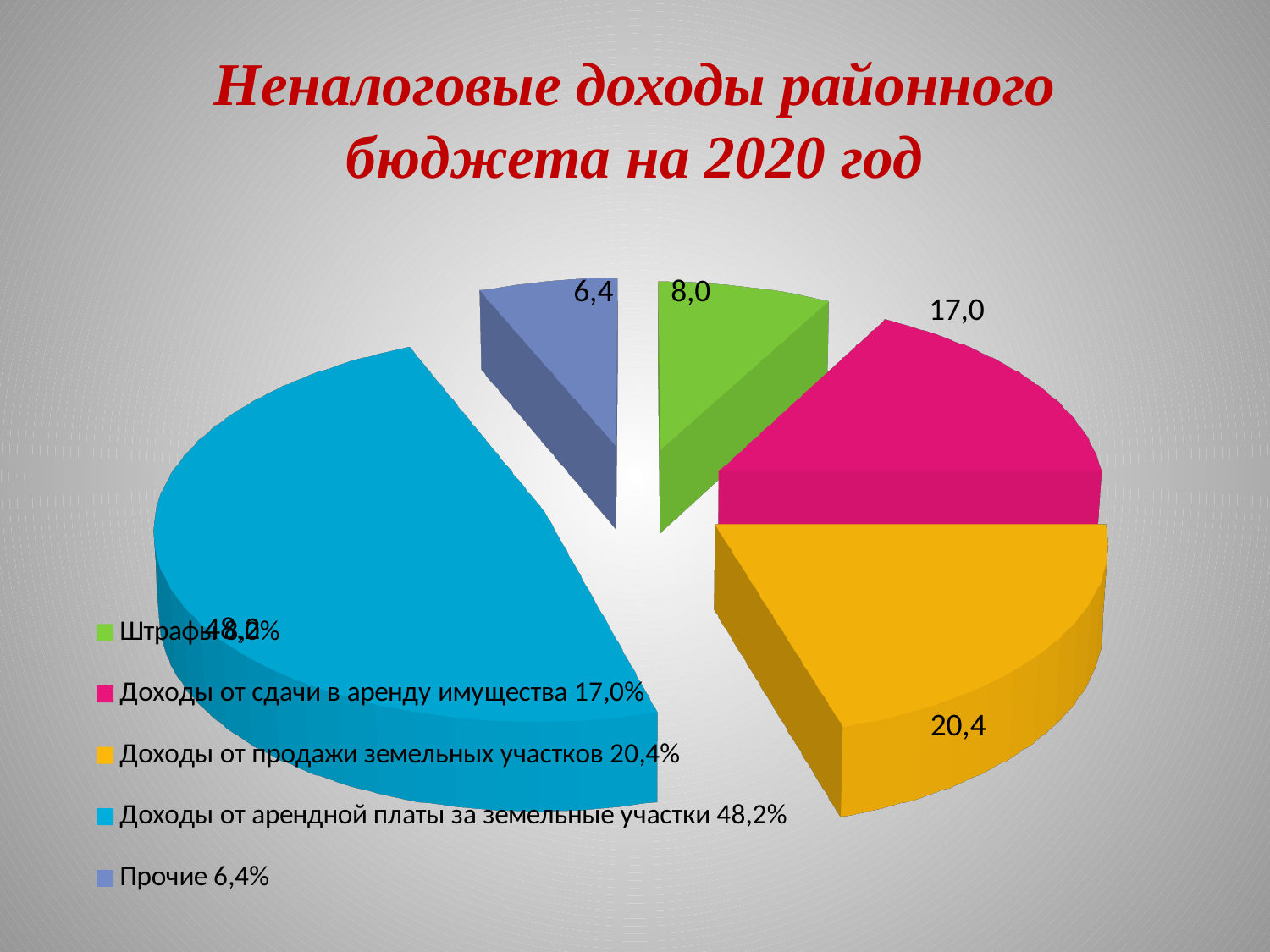
What kind of chart is shown on the slide? pie chart What is the value shown for Прочие? 6,4 What is the title of the chart on the slide? Неналоговые доходы районного бюджета на 2020 год What is the value shown for Штрафы? 8,0 Which category has the largest slice of the pie? Доходы от арендной платы за земельные участки What is the difference between the values for Доходы от продажи земельных участков and Доходы от сдачи в аренду имущества? 3,4 What is the value shown for Доходы от сдачи в аренду имущества? 17,0 What is the value shown for Доходы от продажи земельных участков? 20,4 Which category has the smallest slice of the pie? Прочие What is the value shown for Доходы от арендной платы за земельные участки? 48,2 Which is larger, the value for Штрафы or the value for Прочие? Штрафы How many categories does the pie chart have? 5